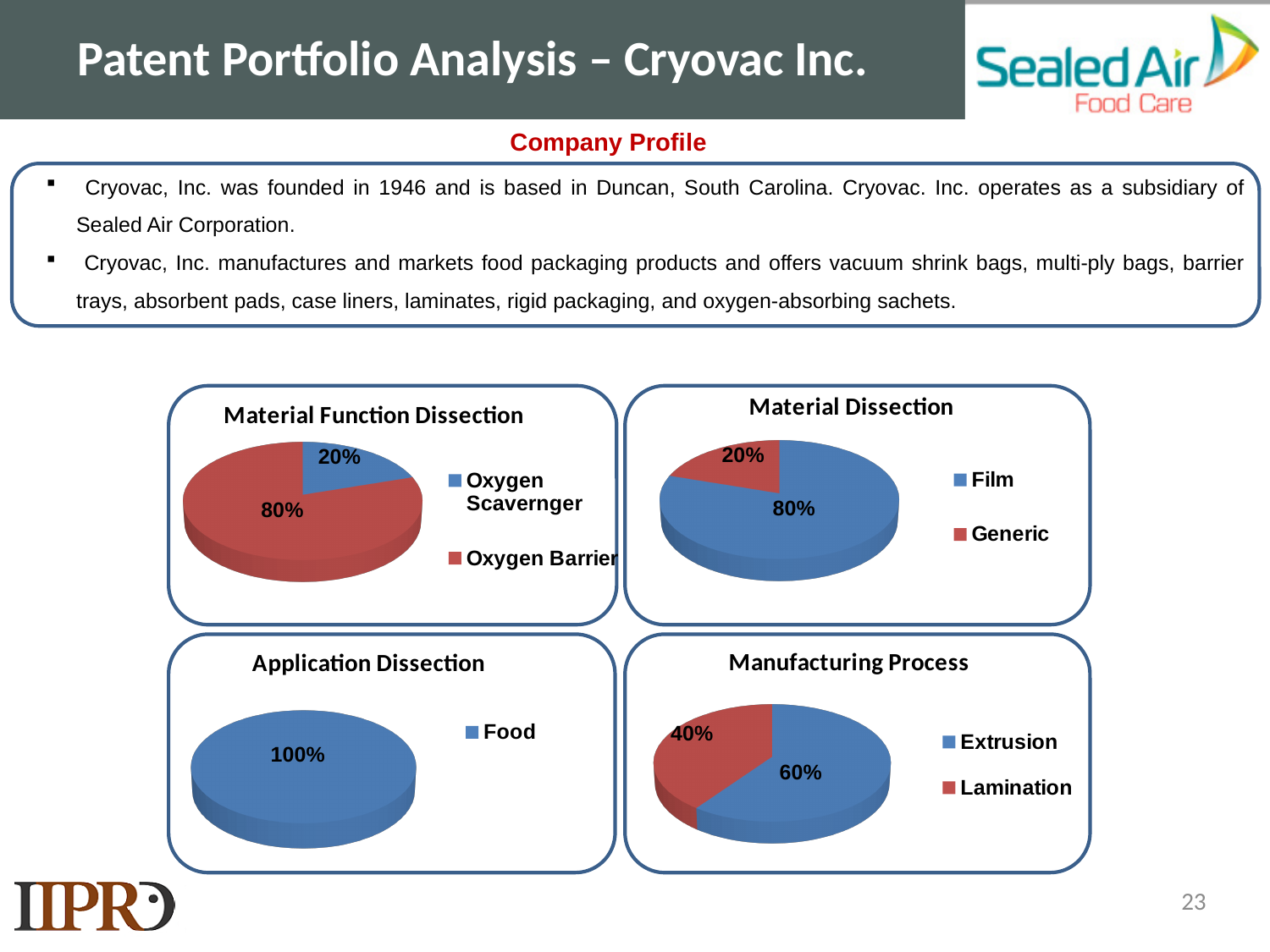
In the Manufacturing Process chart, which category has the largest share? Extrusion In the Material Function Dissection chart, what share does Oxygen Scavernger have? 20% In the Material Function Dissection chart, what share does Oxygen Barrier have? 80% What kind of chart is the Material Dissection chart? Pie chart How many categories does the legend of the Application Dissection chart list? 1 In the Material Function Dissection chart, which is larger, Oxygen Barrier or Oxygen Scavernger? Oxygen Barrier In the Material Dissection chart, what share does Film have? 80% In the Material Dissection chart, which category has the smallest share? Generic How many pie charts are shown on the slide? 4 In the Application Dissection chart, what share does Food have? 100% In the Manufacturing Process chart, what share does Lamination have? 40% In the Manufacturing Process chart, what is the difference between the Extrusion and Lamination shares? 20%